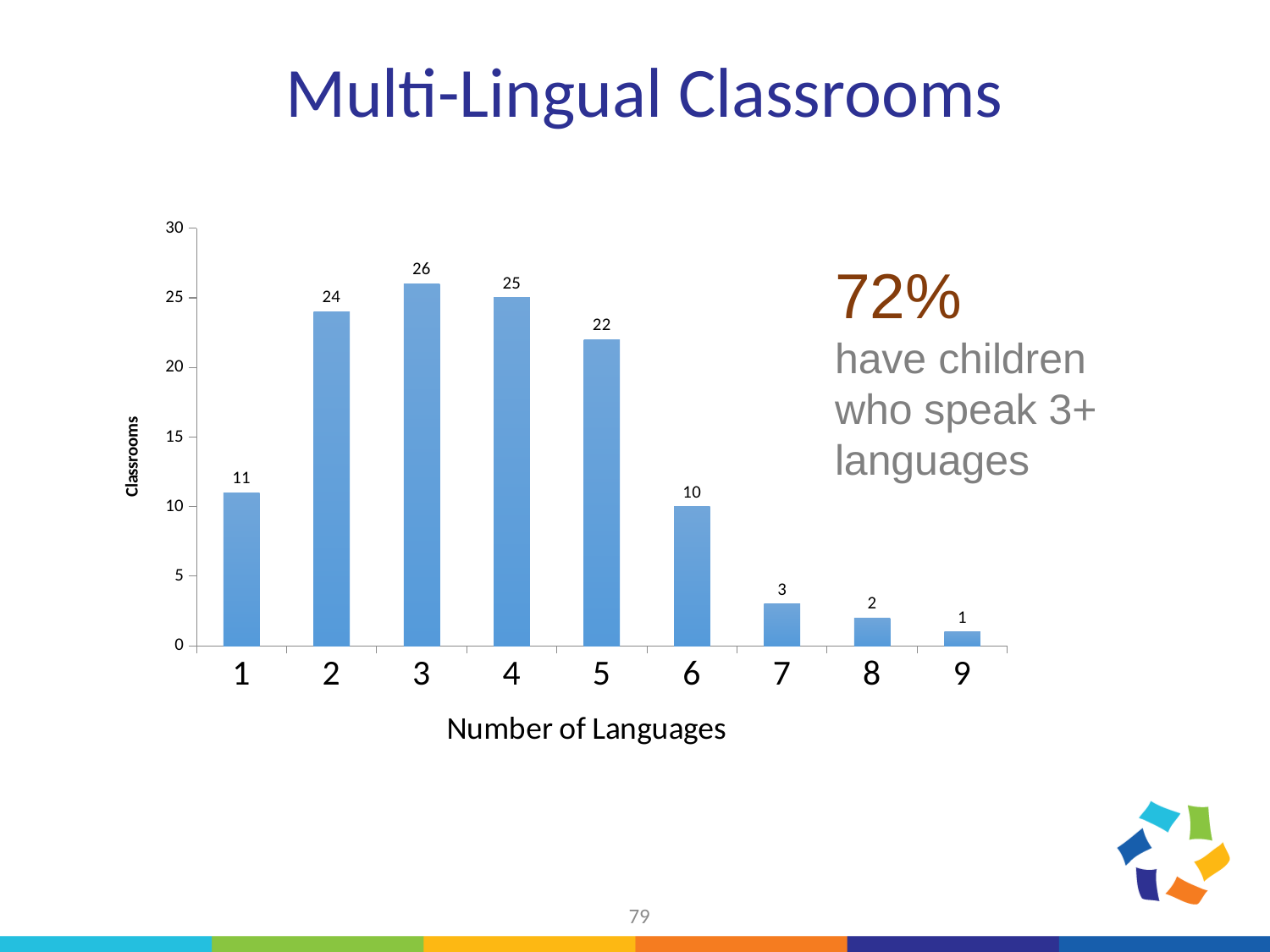
Which number of languages has the highest number of classrooms? 3 Which number of languages has the lowest number of classrooms? 9 How many classrooms have 6 languages? 10 How many categories are shown on the x axis? 9 Is the number of classrooms with 5 languages greater or less than 20? greater Which has more classrooms: 4 languages or 6 languages? 4 languages How many classrooms have 3 languages? 26 What kind of chart is shown on the slide? bar chart Do the values rise or fall from 5 languages to 9 languages? fall What is the label of the x axis? Number of Languages What is the difference in classrooms between 2 languages and 5 languages? 2 How many classrooms have 1 language? 11